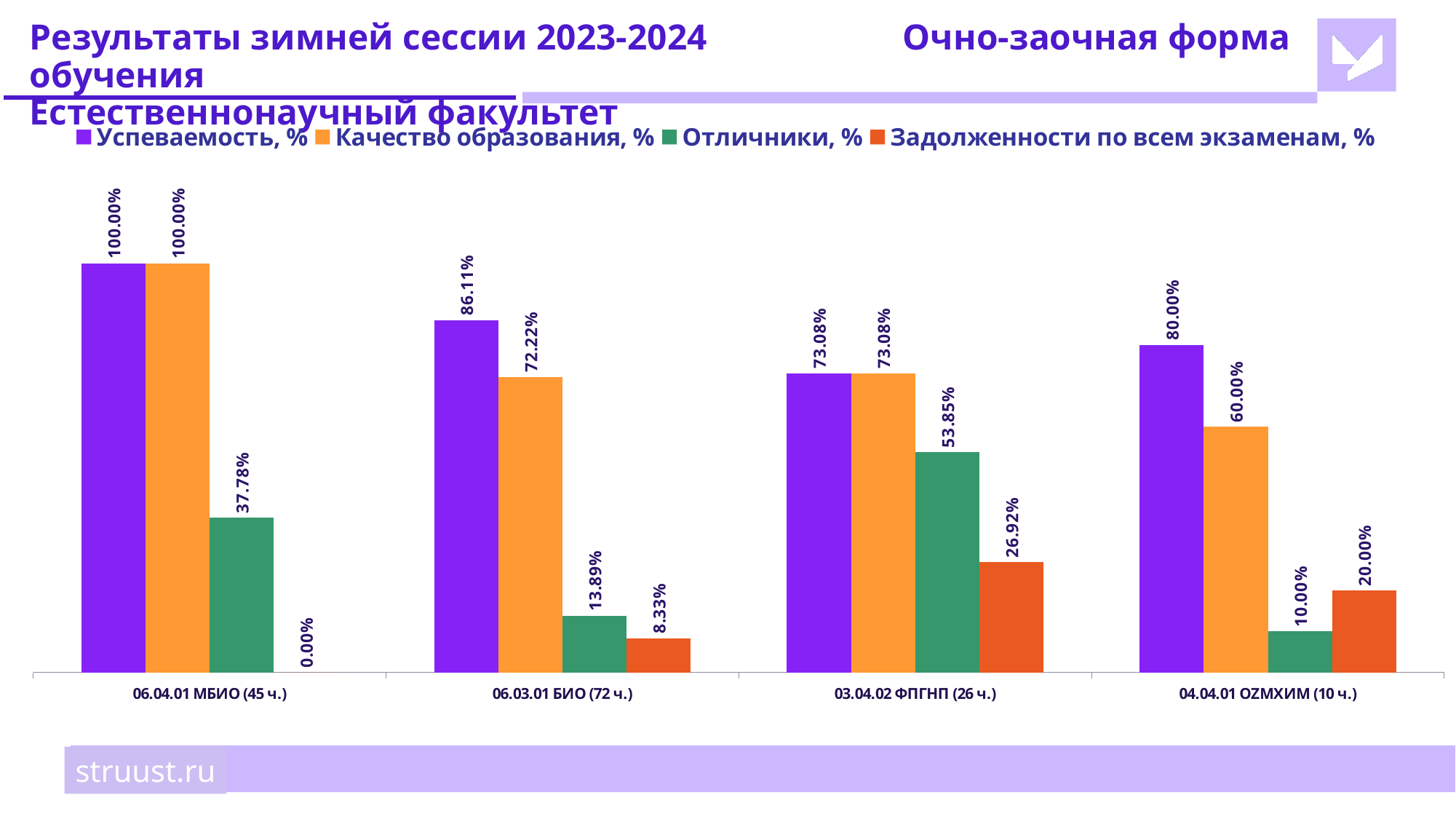
What type of chart is shown on the slide? bar chart How many categories are shown on the x axis? 4 How many series does the legend list? 4 What is the difference between Успеваемость, % and Качество образования, % for 04.04.01 ОZМХИМ (10 ч.)? 20.00% Which is larger for 06.03.01 БИО (72 ч.): Отличники, % or Задолженности по всем экзаменам, %? Отличники, % Which category has the lowest value for Успеваемость, %? 03.04.02 ФПГНП (26 ч.) What is the value of Успеваемость, % for 06.03.01 БИО (72 ч.)? 86.11% What is the value of Отличники, % for 03.04.02 ФПГНП (26 ч.)? 53.85% Which category has the highest value for Отличники, %? 03.04.02 ФПГНП (26 ч.) What is the value of Качество образования, % for 06.04.01 МБИО (45 ч.)? 100.00% Which series is shown in green in the legend? Отличники, % What is the value of Задолженности по всем экзаменам, % for 04.04.01 ОZМХИМ (10 ч.)? 20.00%